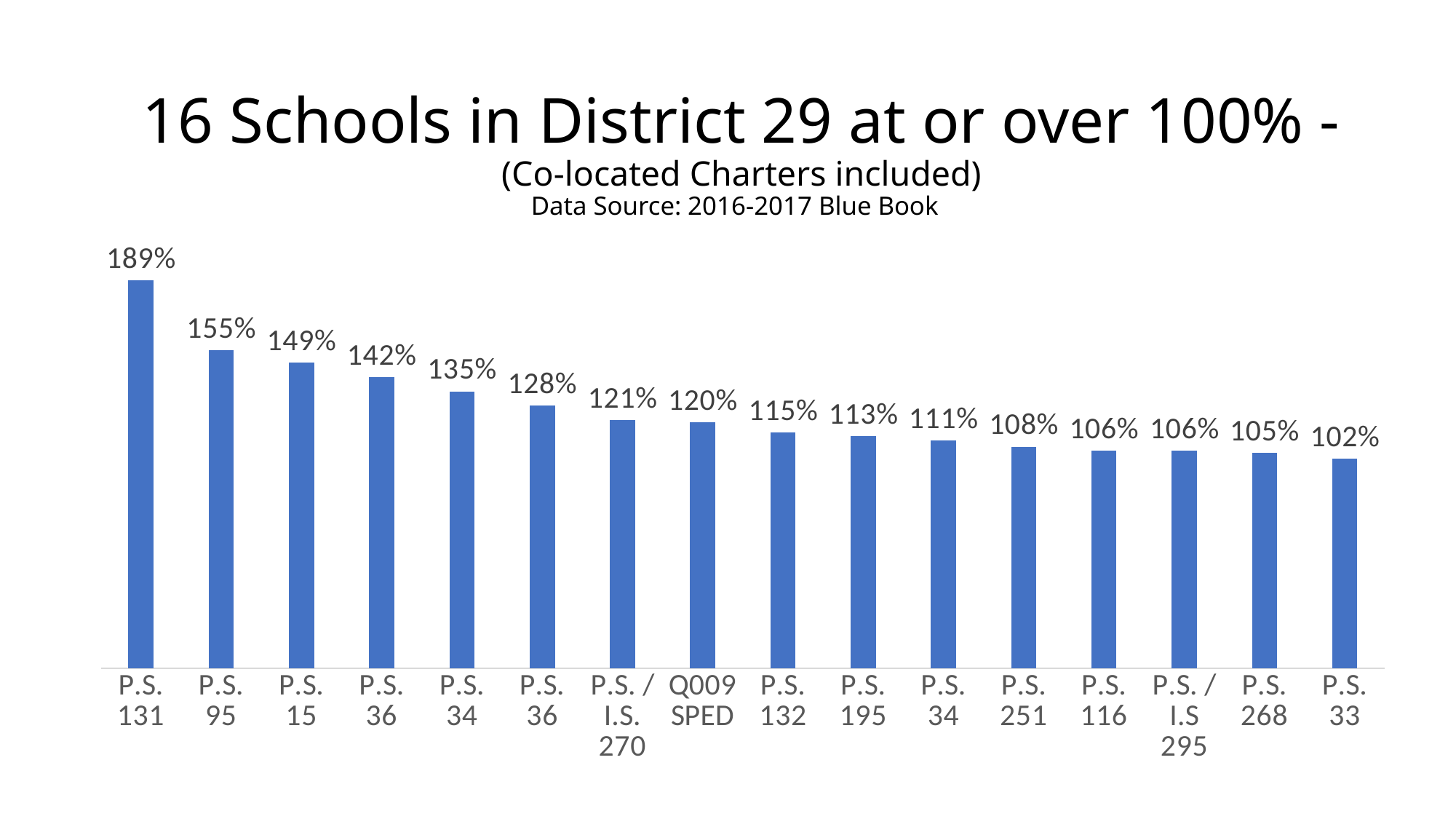
What is the difference between the values for P.S. 131 and P.S. 95? 34% Which school has the lowest value? P.S. 33 Do the values rise or fall from left to right across the chart? Fall How many schools are shown in the chart? 16 What is the value for P.S. 131? 189% What is the value for Q009 SPED? 120% What is the value for P.S. 251? 108% Which is larger, the value for P.S. 15 or the value for P.S. 195? P.S. 15 What is the value for P.S. / I.S. 270? 121% Which school has the highest value? P.S. 131 What kind of chart is shown on the slide? Bar chart What data source is cited under the chart title? 2016-2017 Blue Book